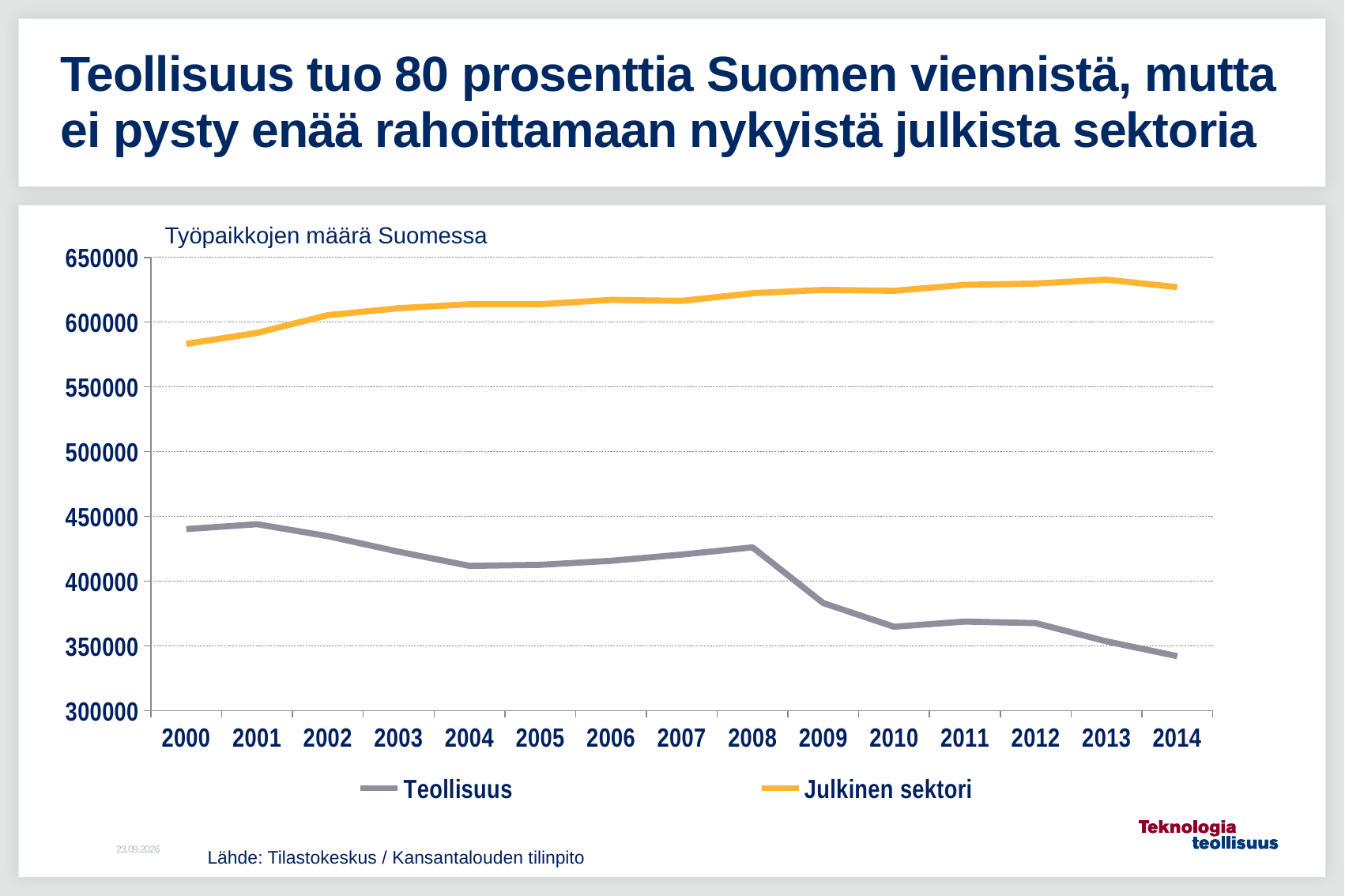
What kind of chart is shown on the slide? line chart Is the value for Teollisuus in 2014 greater or less than 350000? less How many years are plotted along the x axis? 15 Which series is drawn in yellow? Julkinen sektori In which year is the Julkinen sektori series at its lowest? 2000 How many series does the legend list? 2 Does the Teollisuus series rise or fall overall from 2000 to 2014? fall In which year is the Teollisuus series at its lowest? 2014 What is the title of the chart? Työpaikkojen määrä Suomessa Which series has the higher value in 2014, Teollisuus or Julkinen sektori? Julkinen sektori Does the Julkinen sektori series rise or fall overall from 2000 to 2014? rise Is the value for Julkinen sektori in 2000 greater or less than 600000? less